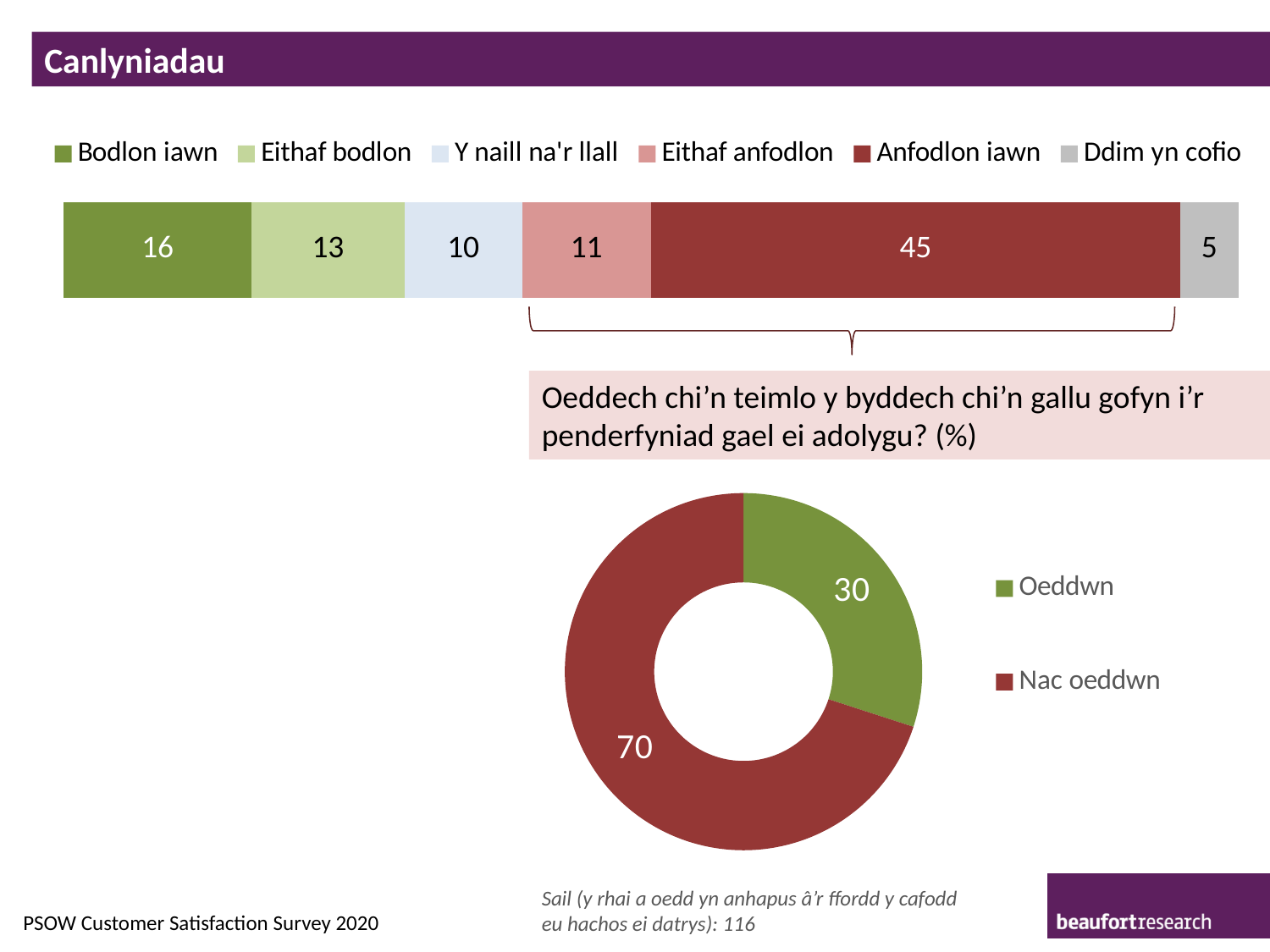
In the stacked bar chart at the top of the slide, which segment has the highest value? Anfodlon iawn In the stacked bar chart at the top of the slide, which segment has the lowest value? Ddim yn cofio What is the total of all segments in the stacked bar chart at the top of the slide? 100 In the stacked bar chart at the top of the slide, what is the value for Anfodlon iawn? 45 How many series does the legend of the stacked bar chart at the top of the slide list? 6 In the stacked bar chart at the top of the slide, what is the value for Bodlon iawn? 16 In the stacked bar chart at the top of the slide, which is larger: Bodlon iawn or Eithaf bodlon? Bodlon iawn What kind of chart is the chart titled 'Oeddech chi'n teimlo y byddech chi'n gallu gofyn i'r penderfyniad gael ei adolygu? (%)'? Donut chart In the chart titled 'Oeddech chi'n teimlo y byddech chi'n gallu gofyn i'r penderfyniad gael ei adolygu? (%)', what is the value for Nac oeddwn? 70 In the chart titled 'Oeddech chi'n teimlo y byddech chi'n gallu gofyn i'r penderfyniad gael ei adolygu? (%)', what is the value for Oeddwn? 30 In the stacked bar chart at the top of the slide, what is the difference between the values for Anfodlon iawn and Eithaf anfodlon? 34 In the stacked bar chart at the top of the slide, what is the value for Y naill na'r llall? 10